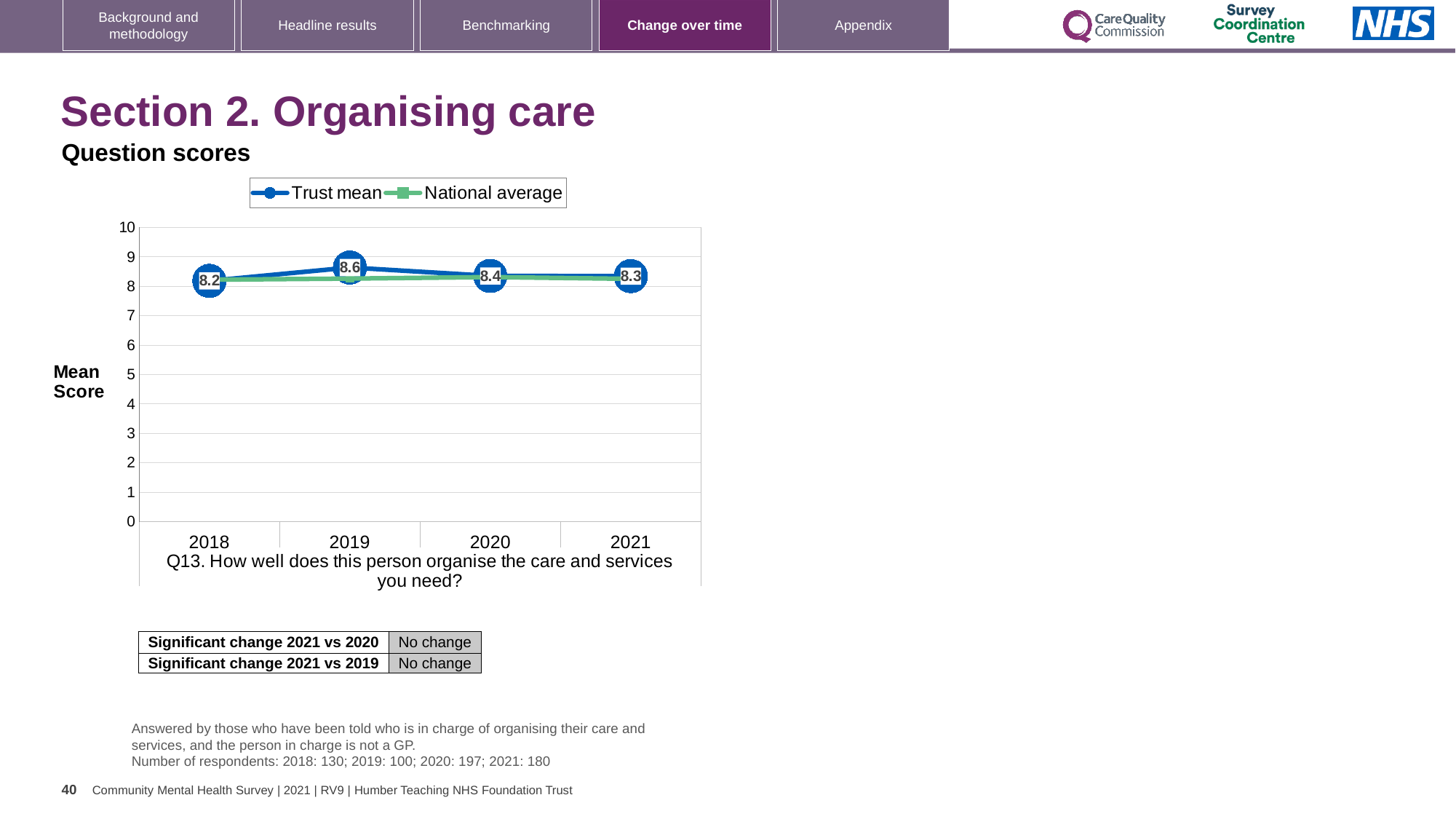
What kind of chart is shown? Line chart Is the National average value for 2020 greater or less than 5? greater What is the Trust mean score for 2018? 8.2 What is the difference between the Trust mean in 2019 and in 2018? 0.4 How many series does the legend list? 2 How many years are plotted on the x axis? 4 What is the Trust mean score for 2019? 8.6 What is the Trust mean score for 2021? 8.3 In which year is the Trust mean lowest? 2018 In which year is the Trust mean highest? 2019 Which is larger, the Trust mean for 2019 or for 2020? 2019 Does the Trust mean rise or fall from 2019 to 2021? Fall